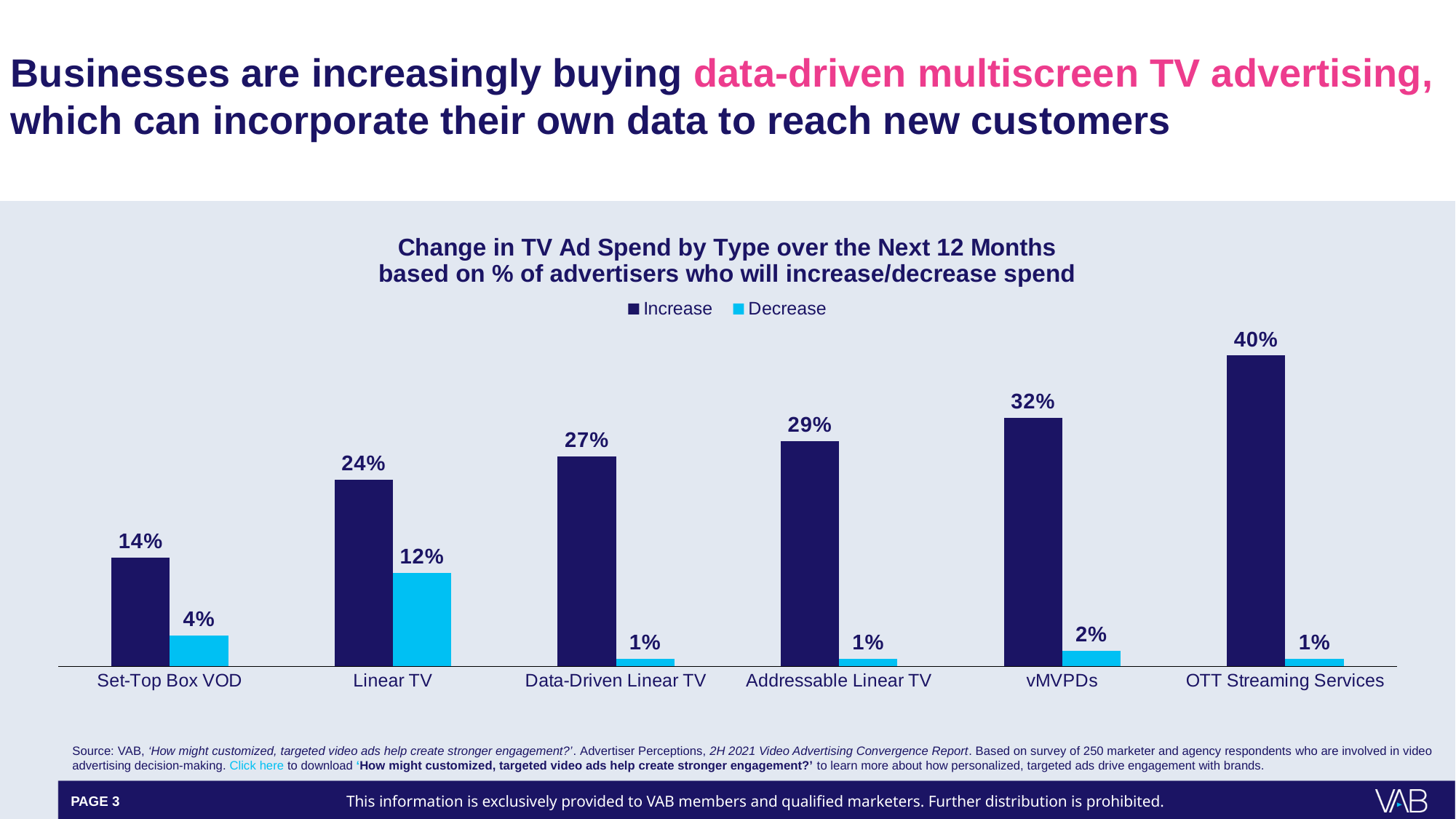
Which category has the highest Increase value? OTT Streaming Services What is the Increase value for Addressable Linear TV? 29% How many categories are shown on the x axis? 6 What kind of chart is shown on the slide? Bar chart What percentage of advertisers will increase spend on OTT Streaming Services? 40% Which category has the lowest Increase value? Set-Top Box VOD How many series does the legend list? 2 What percentage of advertisers will decrease spend on Linear TV? 12% Which is larger: the Increase value for Data-Driven Linear TV or for Linear TV? Data-Driven Linear TV Do the Increase values rise or fall from left to right across the categories? Rise What is the difference between the Increase values for vMVPDs and Set-Top Box VOD? 18% Which category has the highest Decrease value? Linear TV